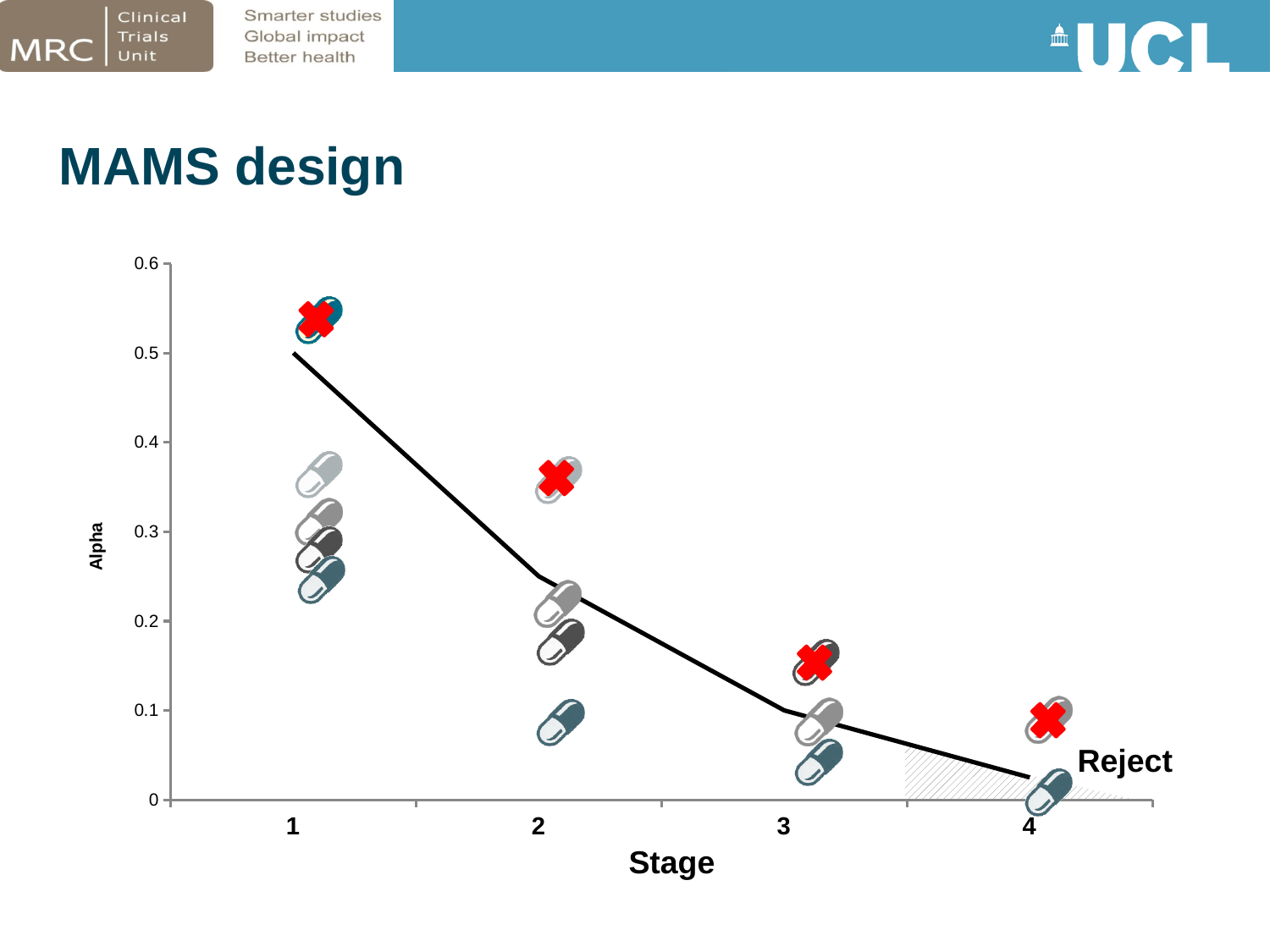
Is the value of the black line at stage 1 greater or less than 0.4? greater Is the black line higher at stage 2 or at stage 3? stage 2 Is the value of the black line at stage 2 greater or less than 0.2? greater Is the value of the black line at stage 4 greater or less than 0.1? less How many stages are shown on the x axis? 4 Does the black line rise or fall as the stage increases from 1 to 4? fall At which stage is the black line highest? 1 What kind of chart is shown on the slide? line chart At which stage is the black line lowest? 4 What is the label of the y axis? Alpha